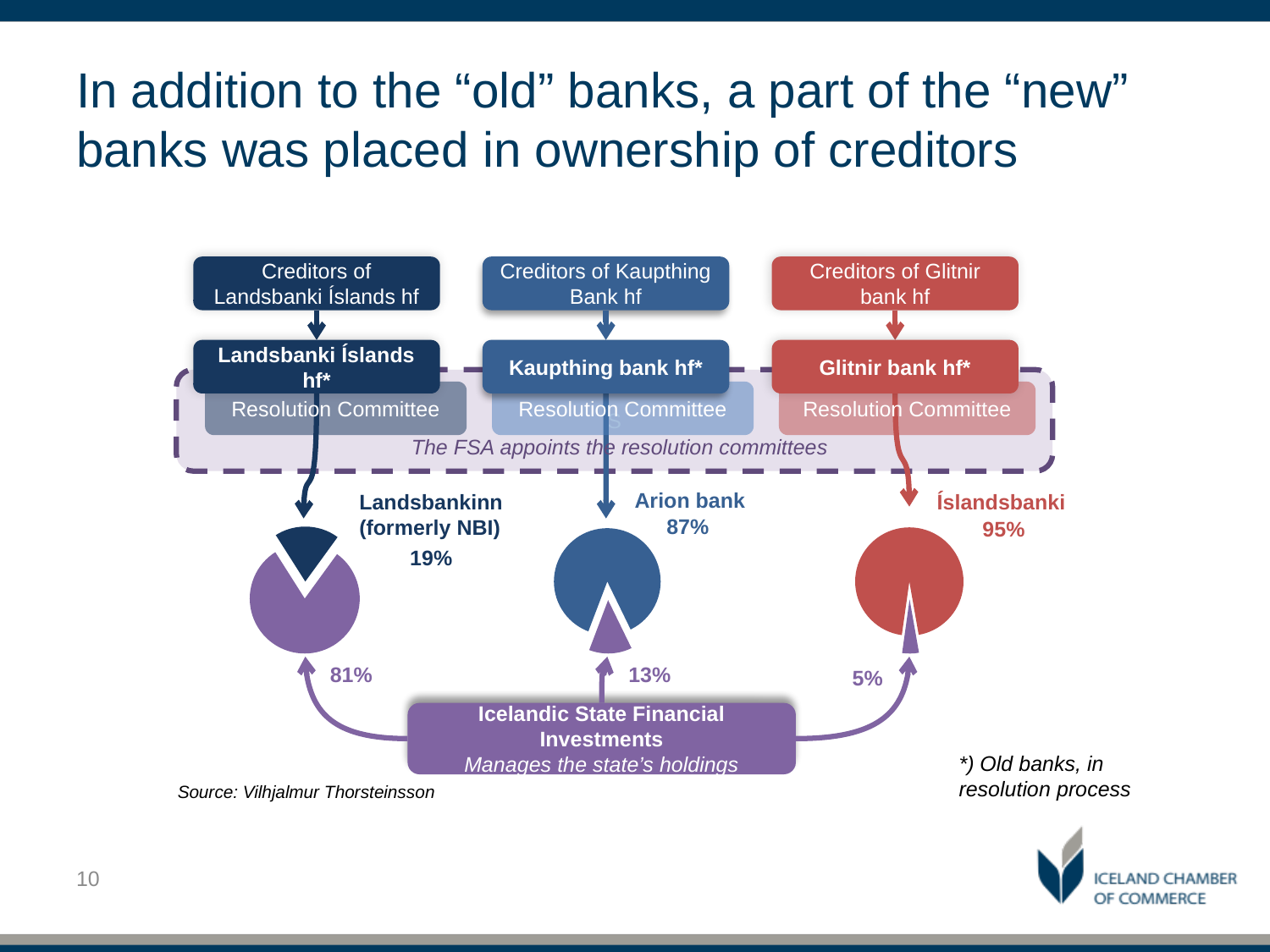
In the Íslandsbanki pie chart, what share is held by the Icelandic State Financial Investments? 5% Which of the three new banks has the smallest share held by the Icelandic State Financial Investments? Íslandsbanki In the Arion bank pie chart, what share is held by the Icelandic State Financial Investments? 13% How many pie charts are shown on the slide? 3 Is the state's share in Arion bank larger or smaller than the state's share in Landsbankinn (formerly NBI)? smaller Which of the three new banks has the largest share held by the Icelandic State Financial Investments? Landsbankinn (formerly NBI) In the Íslandsbanki pie chart, what share is held by the creditors of Glitnir bank hf? 95% In the Landsbankinn (formerly NBI) pie chart, what share is held by the creditors of Landsbanki Íslands hf? 19% What is the difference between the creditors' share in Íslandsbanki and the creditors' share in Arion bank? 8% What kind of chart is used to show the ownership split of each new bank? Pie chart In the Arion bank pie chart, what share is held by the creditors of Kaupthing Bank hf? 87% In the Landsbankinn (formerly NBI) pie chart, what share is held by the Icelandic State Financial Investments? 81%